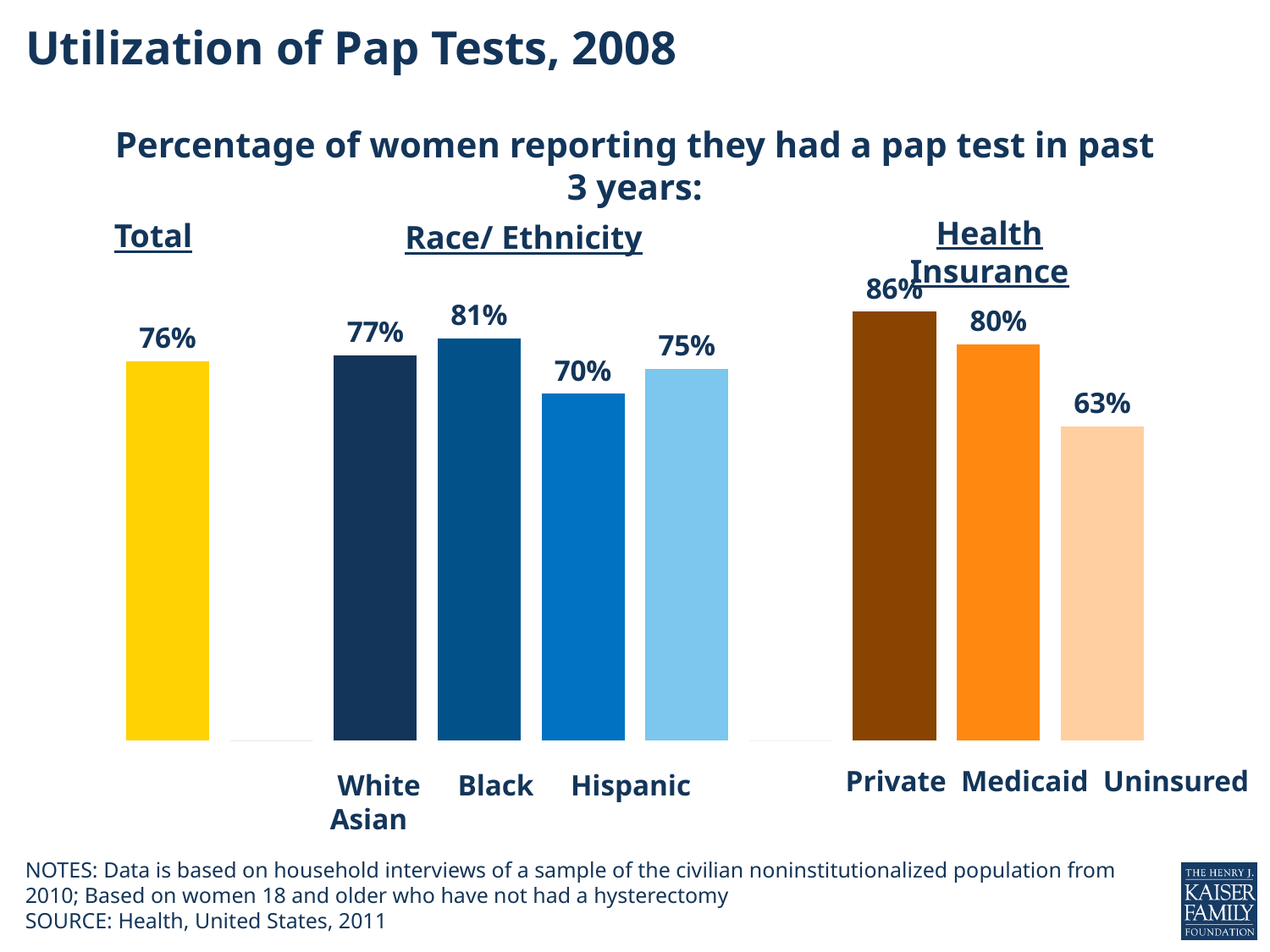
How many bars are plotted on the chart? 8 Which category has the highest percentage on the chart? Private What type of chart is shown on the slide? Bar chart Within the Race/Ethnicity group, which category has the lowest value? Hispanic Which category has the lowest percentage on the chart? Uninsured What is the value for women with private health insurance? 86% What is the value for uninsured women? 63% Which is larger, the value for White women or the value for Medicaid? Medicaid What is the value for Hispanic women? 70% What percentage of women in total reported having a pap test in the past 3 years? 76% What is the difference between the values for Private and Uninsured? 23% What is the value for Black women? 81%